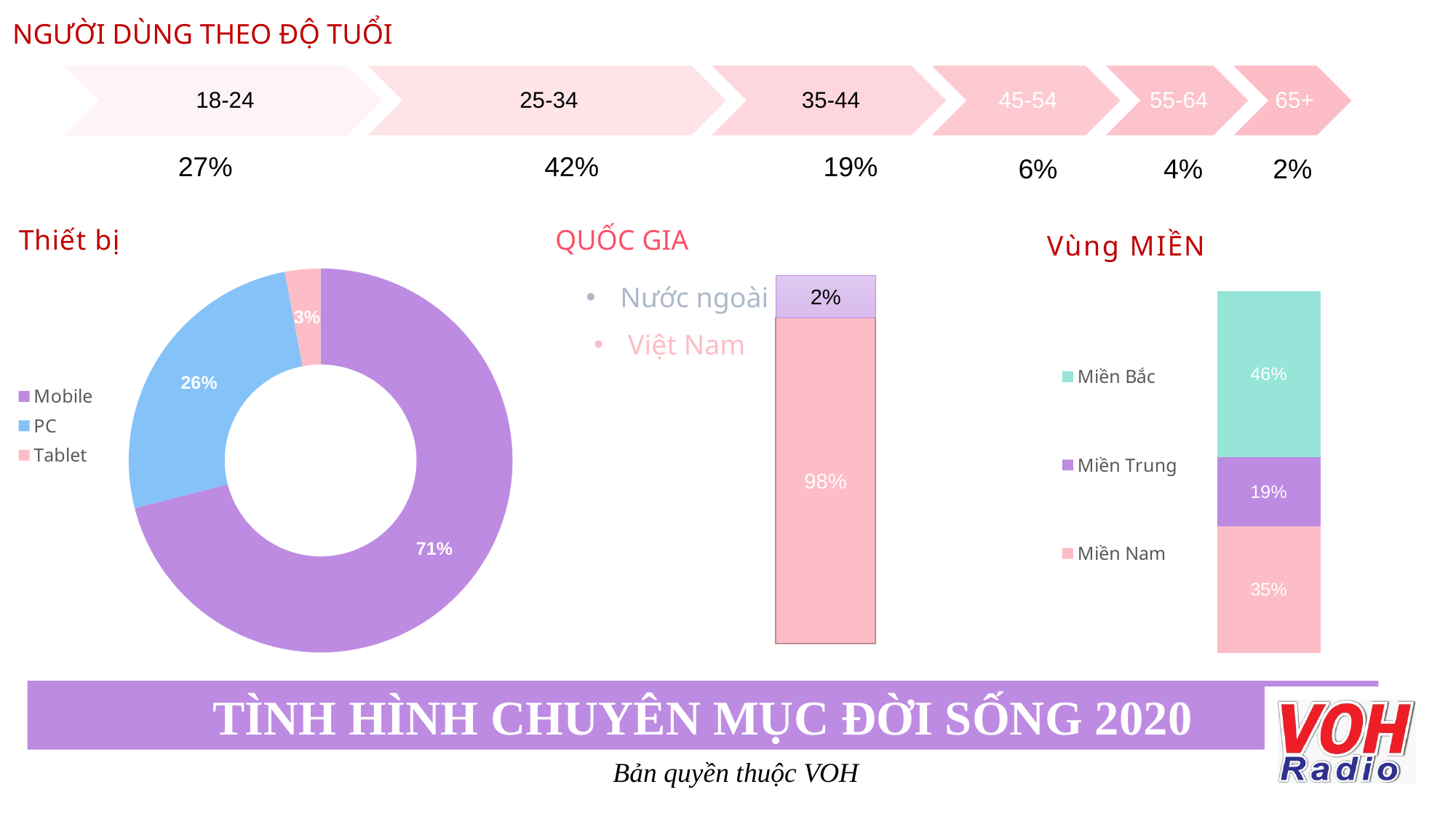
In the "QUỐC GIA" chart, what is the total of the stacked bar? 100% In the "Thiết bị" chart, what is the value for PC? 26% In the "QUỐC GIA" chart, what is the value for Việt Nam? 98% In the "Vùng MIỀN" chart, what is the value for Miền Trung? 19% In the "Thiết bị" chart, what is the difference between Mobile and PC? 45% In the "Thiết bị" chart, what share does Mobile have? 71% What kind of chart is the "Thiết bị" chart? Donut chart In the "Vùng MIỀN" chart, which region has the largest value? Miền Bắc In the "Thiết bị" chart, which category has the smallest share? Tablet In the "QUỐC GIA" chart, what is the value for Nước ngoài? 2% In the "Vùng MIỀN" chart, what is the difference between Miền Bắc and Miền Nam? 11% How many categories does the legend of the "Thiết bị" chart list? 3